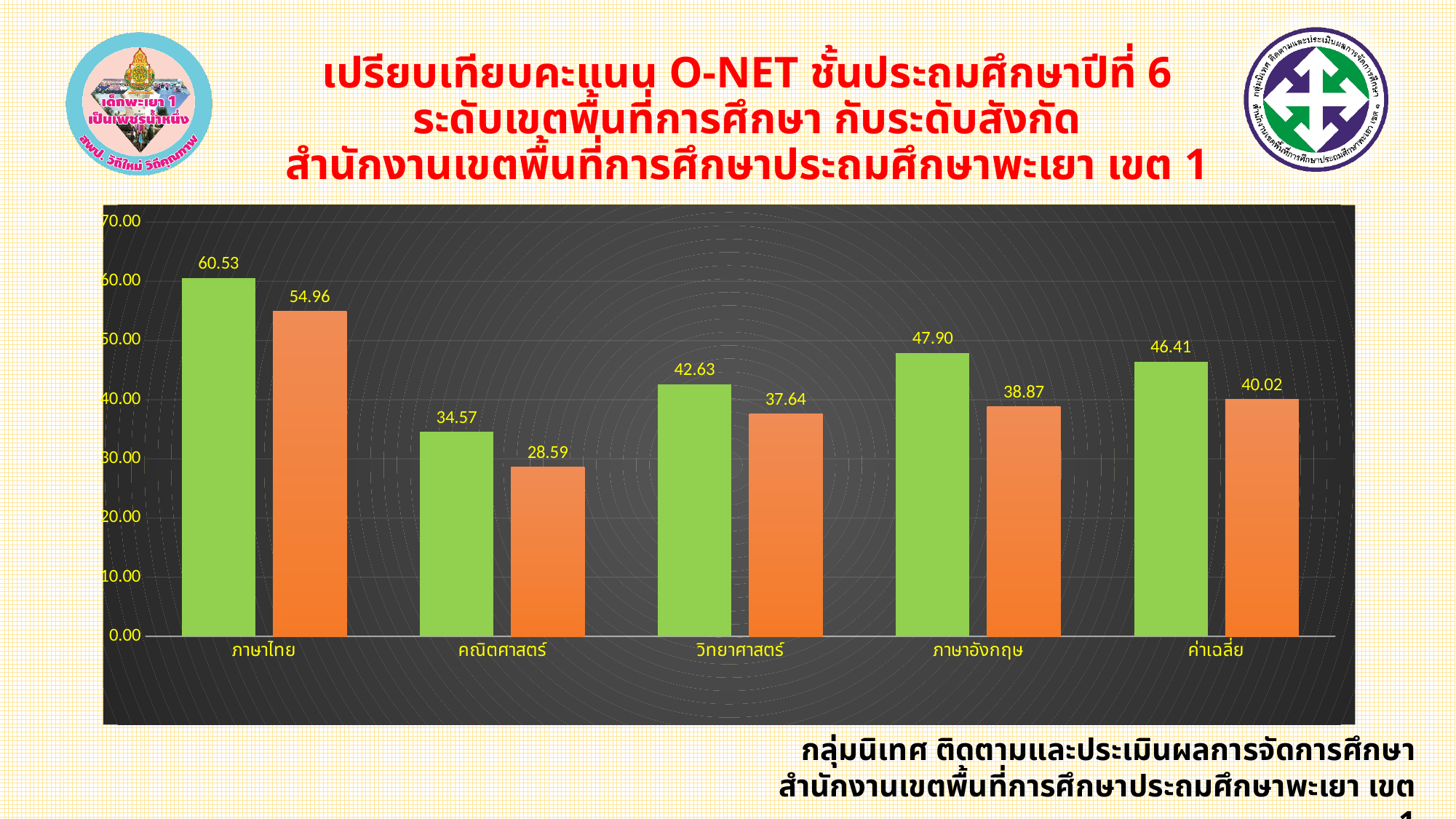
Which is larger for วิทยาศาสตร์, the green bar or the orange bar? the green bar Which category has the highest green bar? ภาษาไทย What is the value of the green bar for วิทยาศาสตร์? 42.63 What is the value of the orange bar for ค่าเฉลี่ย? 40.02 What is the difference between the green bars for ภาษาไทย and คณิตศาสตร์? 25.96 What is the value of the green bar for ภาษาไทย? 60.53 Is the orange bar for ภาษาไทย greater or less than 50.00? greater What is the difference between the green and orange bars for ภาษาอังกฤษ? 9.03 What is the value of the orange bar for คณิตศาสตร์? 28.59 Which category has the lowest orange bar? คณิตศาสตร์ How many categories are shown on the x axis? 5 What kind of chart is shown on the slide? bar chart